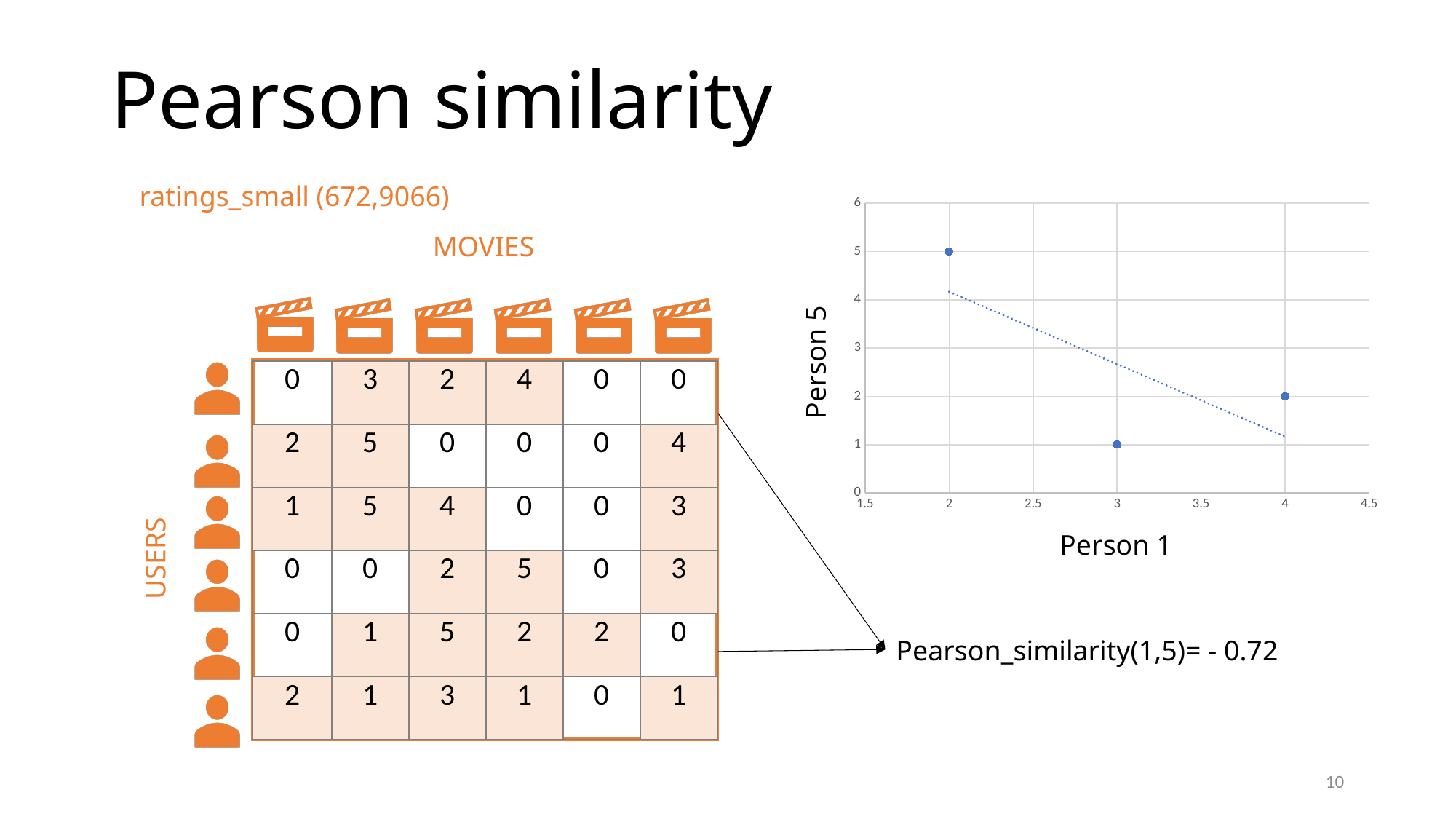
In the scatter chart, is the Person 5 value at Person 1 = 2 greater or less than 4? greater What kind of chart is shown on the right of the slide? scatter chart In the scatter chart, what is the Person 5 value for the point where Person 1 is 3? 1 In the scatter chart, which Person 1 value has the lowest Person 5 value? 3 In the scatter chart, what is the Person 5 value for the point where Person 1 is 4? 2 In the scatter chart, what is the Person 5 value for the point where Person 1 is 2? 5 In the scatter chart, what is the difference between the Person 5 values at Person 1 = 2 and Person 1 = 4? 3 In the scatter chart, which Person 1 value has the highest Person 5 value? 2 What is the label of the x axis of the scatter chart? Person 1 What is the label of the y axis of the scatter chart? Person 5 How many data points are plotted in the scatter chart? 3 Does the dotted trend line in the scatter chart rise or fall as Person 1 increases? fall